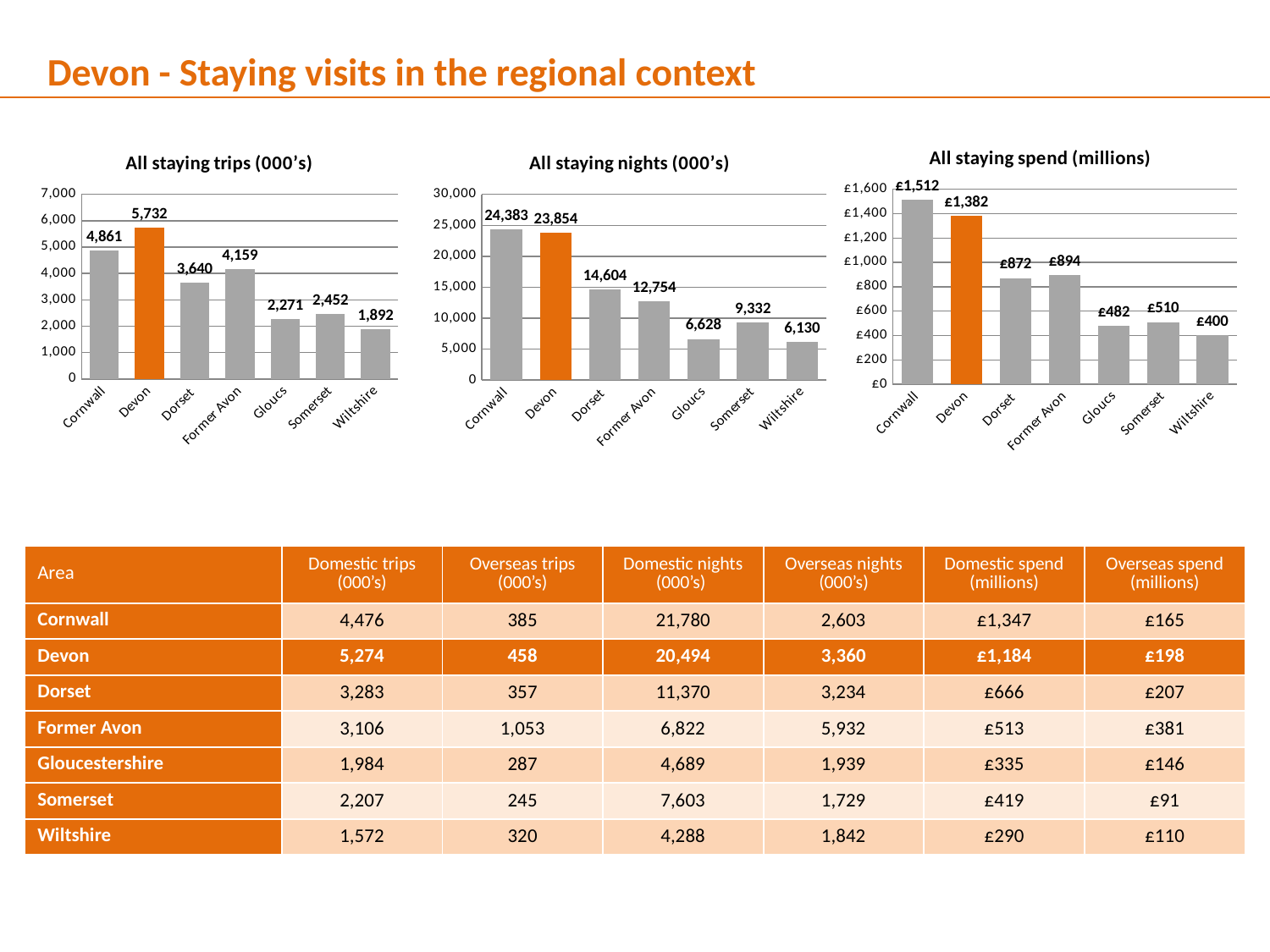
In the 'All staying nights (000's)' chart, what is the value for Former Avon? 12,754 How many areas are shown in the 'All staying trips (000's)' chart? 7 In the 'All staying trips (000's)' chart, what is the value for Devon? 5,732 In the 'All staying spend (millions)' chart, which area has the lowest value? Wiltshire In the 'All staying nights (000's)' chart, which area has the highest value? Cornwall In the 'All staying trips (000's)' chart, what is the difference between Devon and Cornwall? 871 In the 'All staying spend (millions)' chart, what is the value for Dorset? £872 In the 'All staying trips (000's)' chart, which area has the lowest value? Wiltshire In the 'All staying trips (000's)' chart, which bar is highlighted in orange? Devon In the 'All staying nights (000's)' chart, which is larger, Somerset or Gloucs? Somerset What type of chart is the 'All staying spend (millions)' chart? Bar chart In the 'All staying spend (millions)' chart, what is the difference between Cornwall and Devon? £130